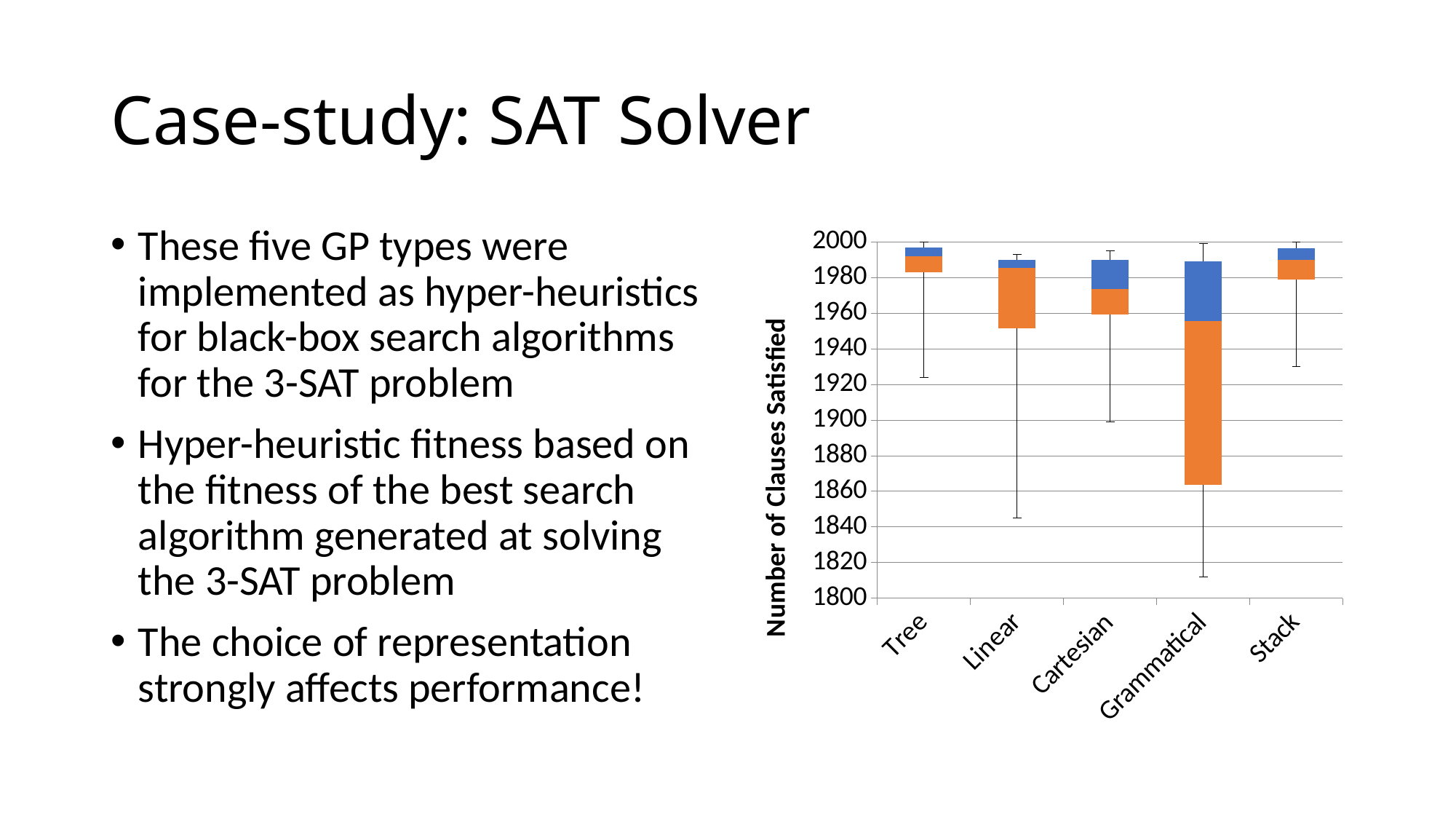
Is the bottom of the lower whisker for Tree greater or less than 1900? greater What kind of chart is shown on the slide? bar chart Is the bottom of the lower whisker for Cartesian greater or less than 1920? less Is the bottom of the lower whisker for Linear greater or less than 1860? less Which category has the lowest bottom whisker in the chart? Grammatical Which has a lower bottom whisker, Linear or Stack? Linear What is the label of the vertical axis of the chart? Number of Clauses Satisfied How many GP types (categories) are shown on the x axis of the chart? 5 Which category has the tallest (widest-ranging) box in the chart? Grammatical